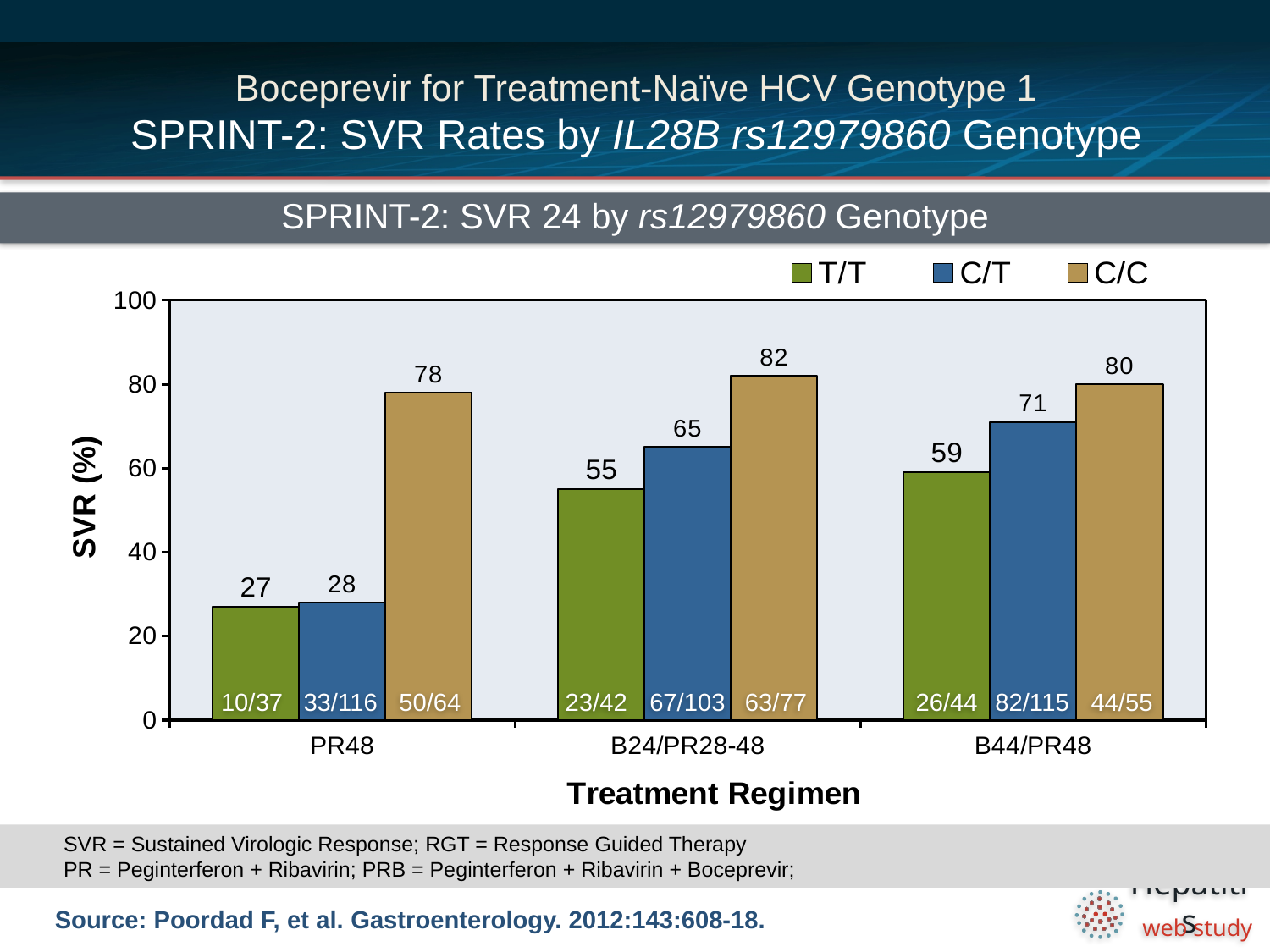
Which is larger: the SVR (%) for C/T in B24/PR28-48 or the SVR (%) for T/T in B44/PR48? C/T in B24/PR28-48 What is the SVR (%) for the C/T genotype in the B44/PR48 regimen? 71 What fraction is printed inside the C/T bar for the B24/PR28-48 regimen? 67/103 Which treatment regimen has the lowest SVR (%) for the T/T genotype? PR48 What kind of chart is shown on the slide? Bar chart What is the label of the y axis? SVR (%) How many series does the legend list? 3 What is the SVR (%) for the C/C genotype in the PR48 regimen? 78 What is the difference in SVR (%) between the C/C and T/T genotypes in the PR48 regimen? 51 Which genotype has the highest SVR (%) in the B24/PR28-48 regimen? C/C How many treatment regimens are shown on the x axis? 3 What is the SVR (%) for the T/T genotype in the B24/PR28-48 regimen? 55